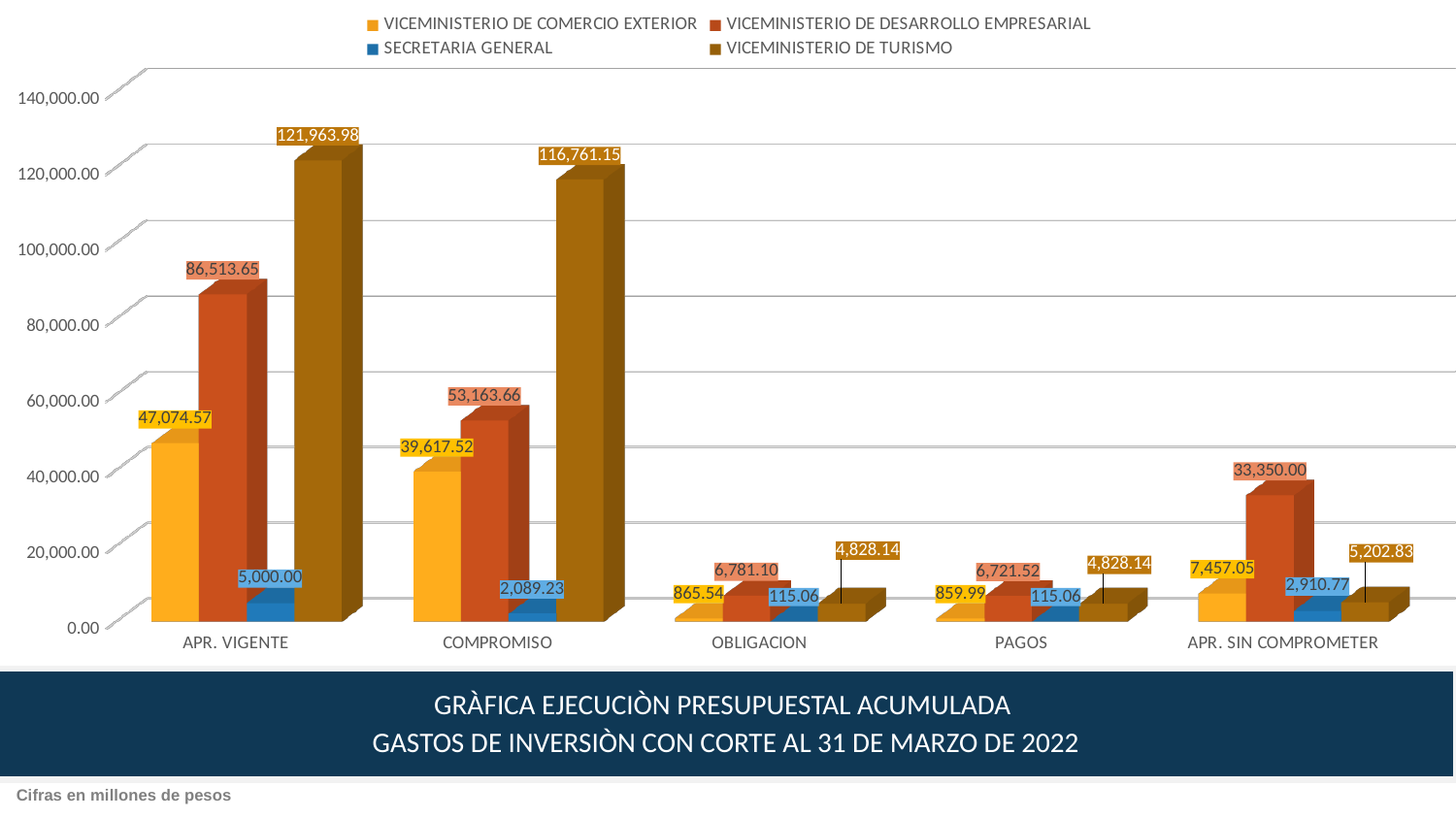
How many categories are shown on the x axis? 5 What is the difference between the VICEMINISTERIO DE TURISMO values for APR. VIGENTE and COMPROMISO? 5,202.83 Is the value for VICEMINISTERIO DE DESARROLLO EMPRESARIAL in APR. VIGENTE greater or less than 80,000.00? greater How many series does the legend list? 4 Which series has the lowest value in the OBLIGACION category? SECRETARIA GENERAL In the OBLIGACION category, which is larger: VICEMINISTERIO DE DESARROLLO EMPRESARIAL or VICEMINISTERIO DE TURISMO? VICEMINISTERIO DE DESARROLLO EMPRESARIAL What is the value for VICEMINISTERIO DE DESARROLLO EMPRESARIAL in the APR. SIN COMPROMETER category? 33,350.00 What is the value for VICEMINISTERIO DE TURISMO in the APR. VIGENTE category? 121,963.98 What is the difference between the SECRETARIA GENERAL values for APR. VIGENTE and COMPROMISO? 2,910.77 Which series has the highest value in the COMPROMISO category? VICEMINISTERIO DE TURISMO What is the value for SECRETARIA GENERAL in the COMPROMISO category? 2,089.23 What is the value for VICEMINISTERIO DE COMERCIO EXTERIOR in the PAGOS category? 859.99